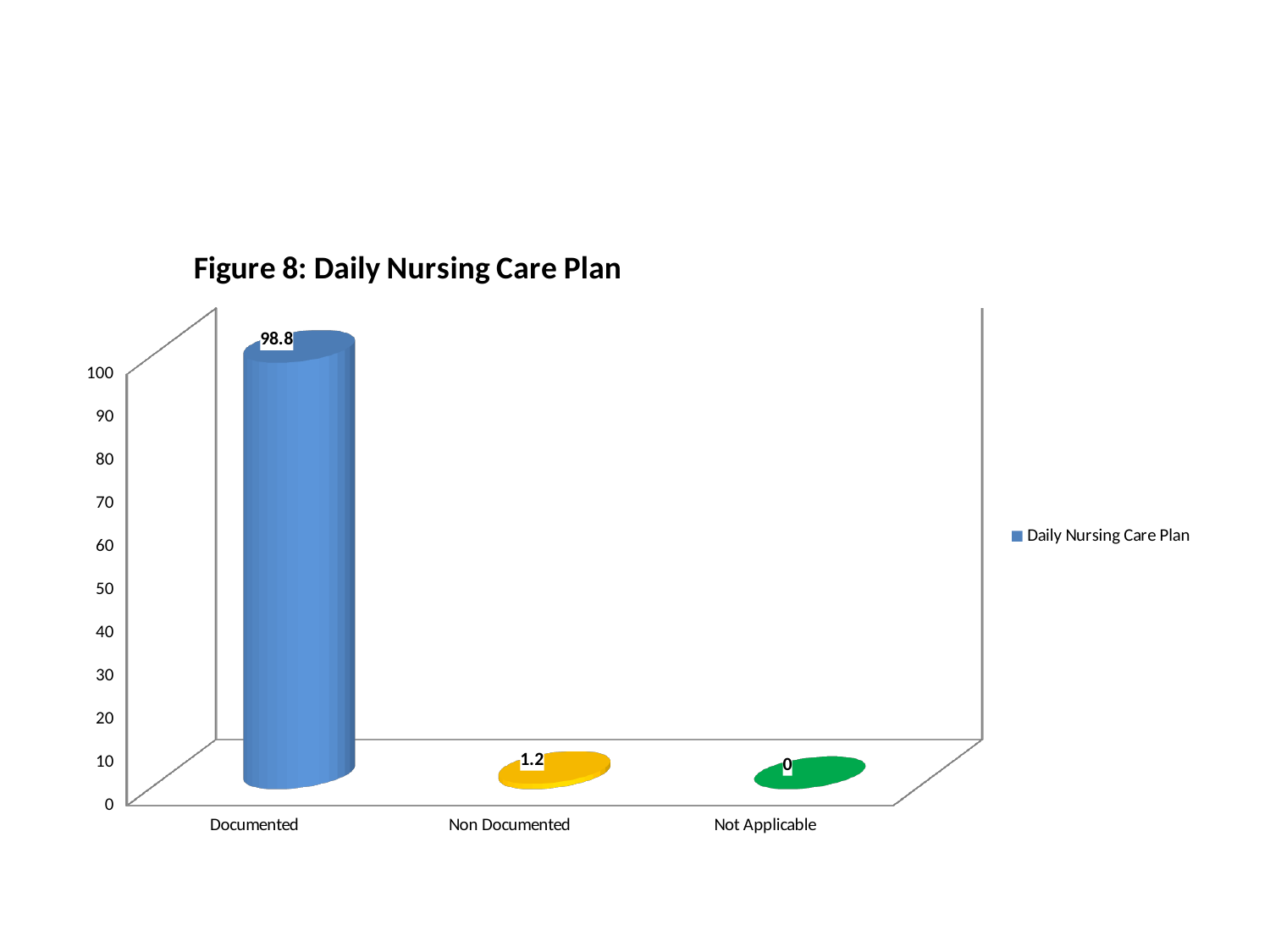
Which is larger, the value for Non Documented or the value for Not Applicable? Non Documented How many series does the legend list? 1 What is the value for Not Applicable? 0 Which category has the highest value? Documented Is the value for Documented greater or less than 90? greater Which category has the lowest value? Not Applicable What is the value for Documented? 98.8 What is the difference between the values for Documented and Non Documented? 97.6 How many categories are shown on the x axis? 3 What is the value for Non Documented? 1.2 What is the title of the chart? Figure 8: Daily Nursing Care Plan What kind of chart is shown on the slide? Bar chart